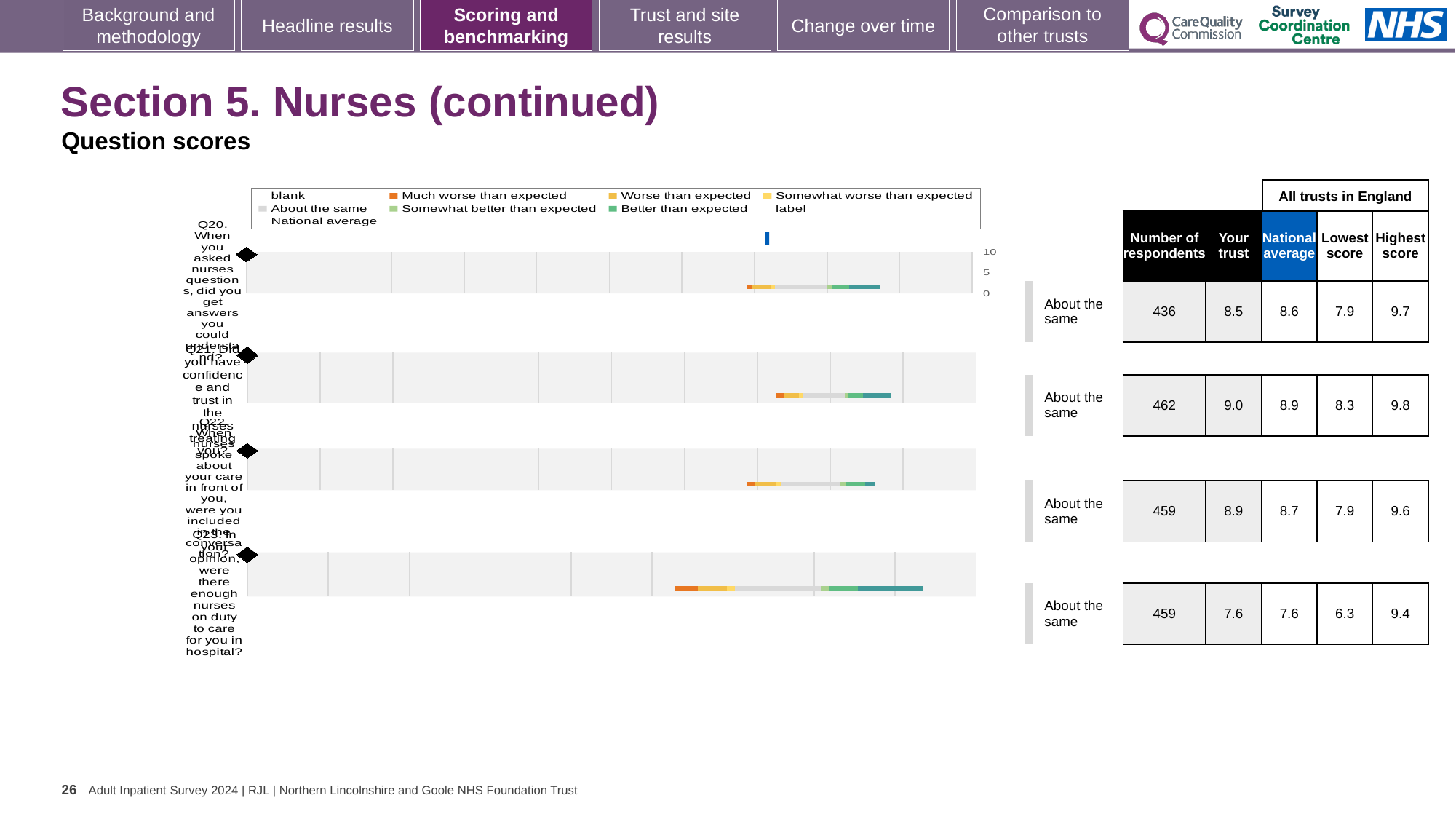
How many questions (rows) are plotted in the chart? 4 For Q21, what is the difference between the highest score and the lowest score across all trusts in England? 1.5 What kind of chart is shown on the slide? Bar chart What is the highest score across all trusts in England for Q22? 9.6 What is the national average for Q23? 7.6 What is the 'Your trust' score for Q21? 9.0 What is the number of respondents for Q20? 436 What benchmark category is shown for Q22? About the same Which question has the highest 'Your trust' score? Q21 What is the lowest score across all trusts in England for Q23? 6.3 Which question has the lowest 'Your trust' score? Q23 For Q20, which is larger: the 'Your trust' score or the national average? National average